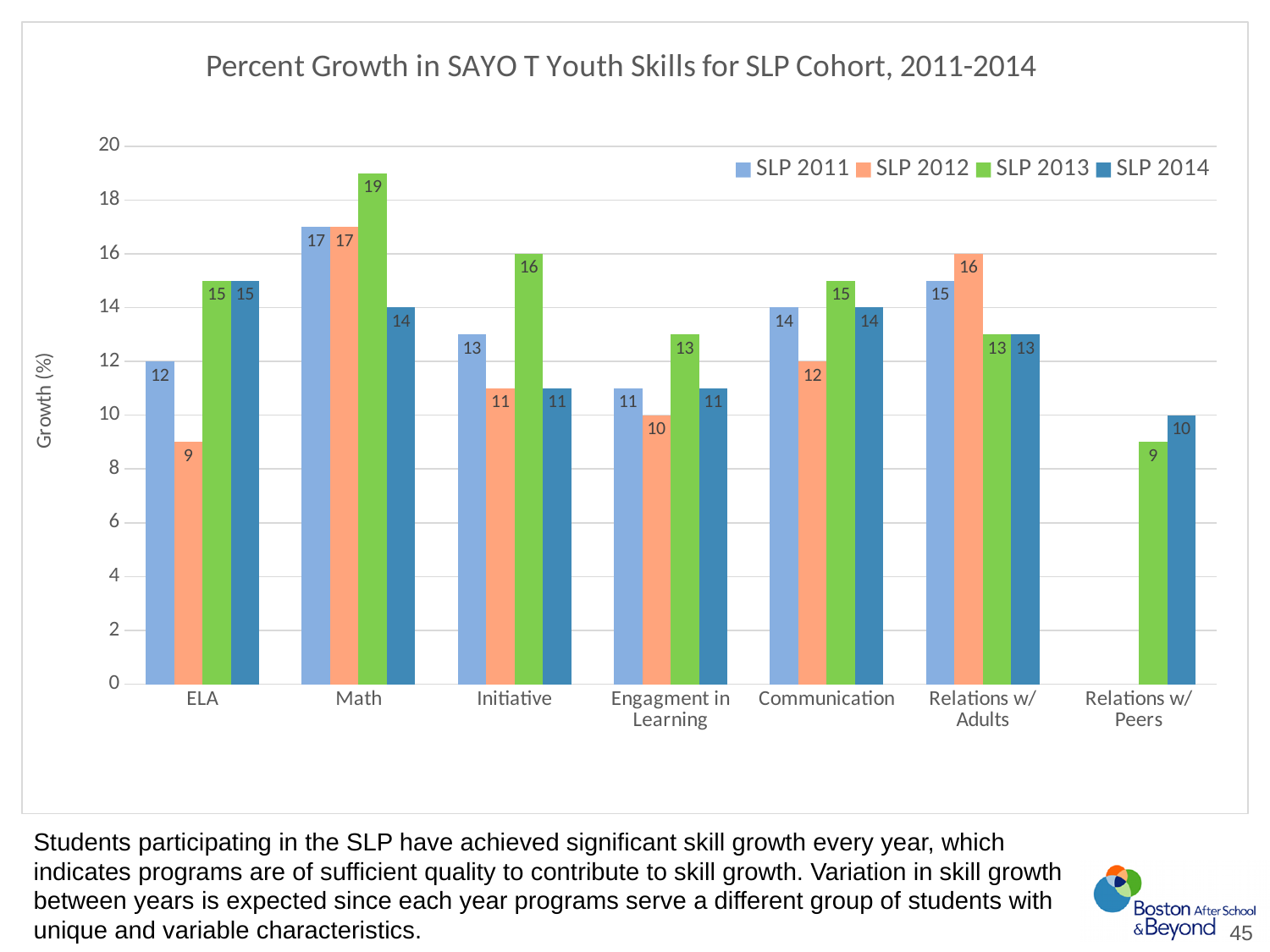
What is the label of the y axis? Growth (%) What is the SLP 2013 value for Math? 19 What is the title of the chart? Percent Growth in SAYO T Youth Skills for SLP Cohort, 2011-2014 What kind of chart is this? Bar chart How many categories are shown on the x axis? 7 Which category has the highest SLP 2013 value? Math What is the difference between the SLP 2013 and SLP 2014 values for Initiative? 5 What is the SLP 2012 value for ELA? 9 What is the SLP 2014 value for Relations w/ Peers? 10 Which category has the lowest SLP 2011 value? Engagment in Learning Which is larger for Relations w/ Adults: the SLP 2012 value or the SLP 2013 value? SLP 2012 How many series does the legend list? 4